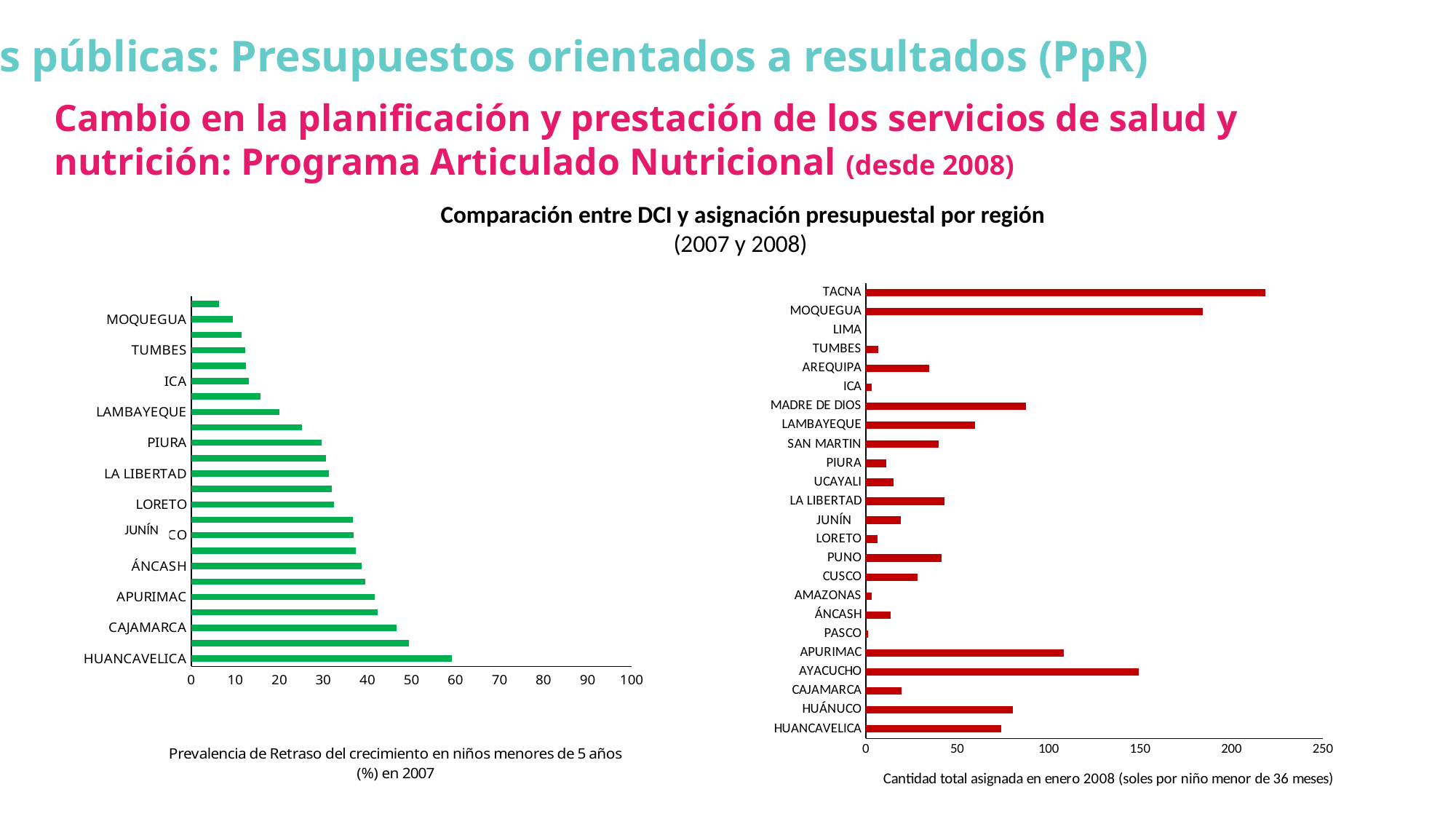
How many regions are listed in the right chart (Cantidad total asignada en enero 2008)? 24 In the right chart (Cantidad total asignada en enero 2008), which is larger, the value for AYACUCHO or for APURIMAC? AYACUCHO In the right chart (Cantidad total asignada en enero 2008), is the value for HUANCAVELICA greater or less than 100? less In the left chart (Prevalencia de Retraso del crecimiento), is the value for HUANCAVELICA greater or less than 50? greater In the right chart (Cantidad total asignada en enero 2008), is the value for APURIMAC greater or less than 100? greater In the right chart (Cantidad total asignada en enero 2008), which region has the highest value? TACNA In the left chart (Prevalencia de Retraso del crecimiento), which is larger, the value for PIURA or for LAMBAYEQUE? PIURA In the left chart (Prevalencia de Retraso del crecimiento), which labelled region has the highest value? HUANCAVELICA What colour are the bars in the right chart (Cantidad total asignada en enero 2008)? red What kind of chart is the left chart showing prevalence of stunting in 2007? bar chart